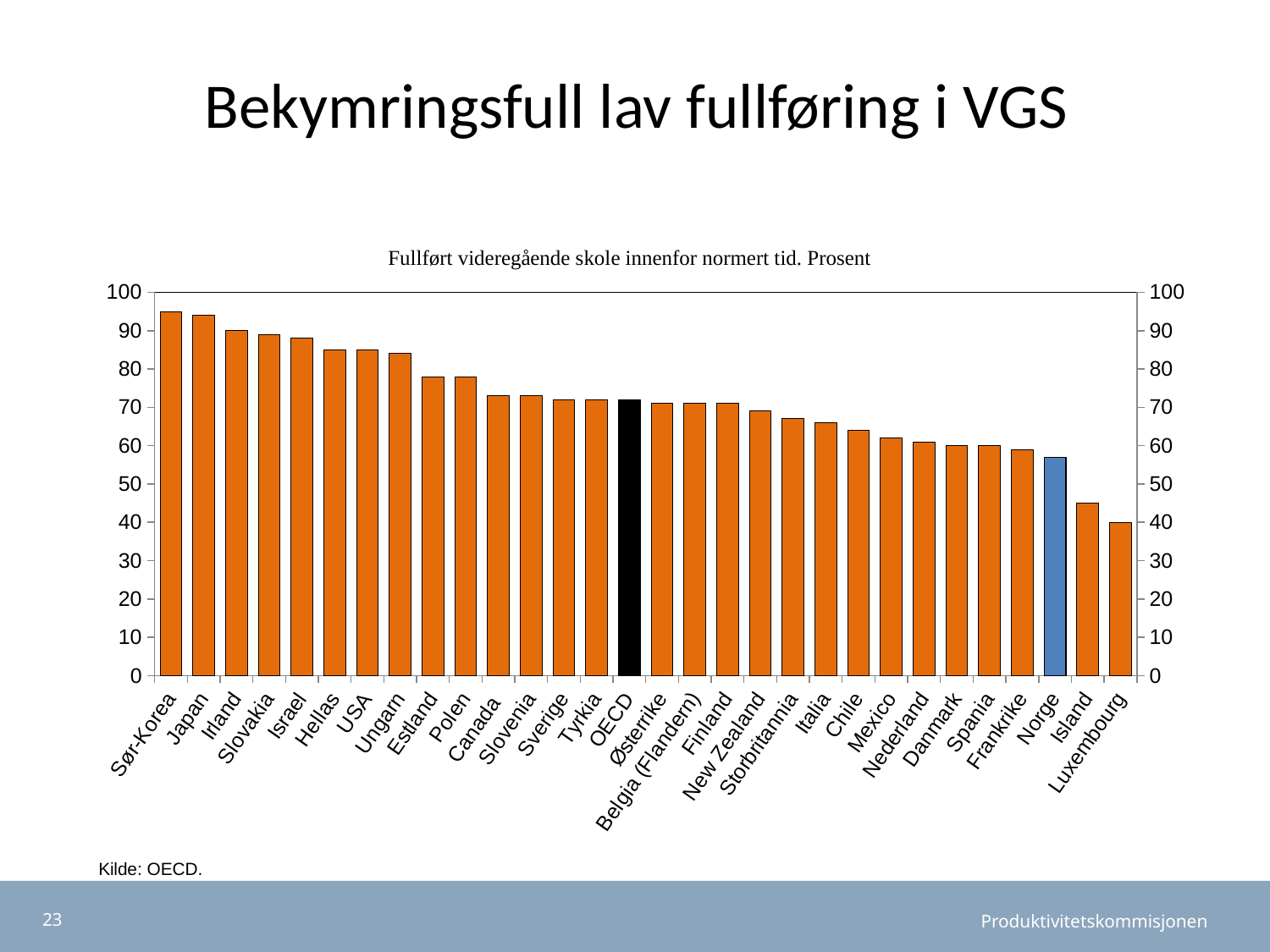
How many bars (countries/groups) are plotted in the chart? 30 Which has the larger value, Norge or Island? Norge What kind of chart is shown on the slide? bar chart Which has the larger value, Frankrike or Irland? Irland Which country has the lowest value in the chart? Luxembourg Is the value for Norge greater or less than 50? greater Is the value for Irland greater or less than 80? greater Is the value for Sør-Korea greater or less than 90? greater What is the title of the chart? Fullført videregående skole innenfor normert tid. Prosent Do the values rise or fall moving from left to right along the x axis? fall